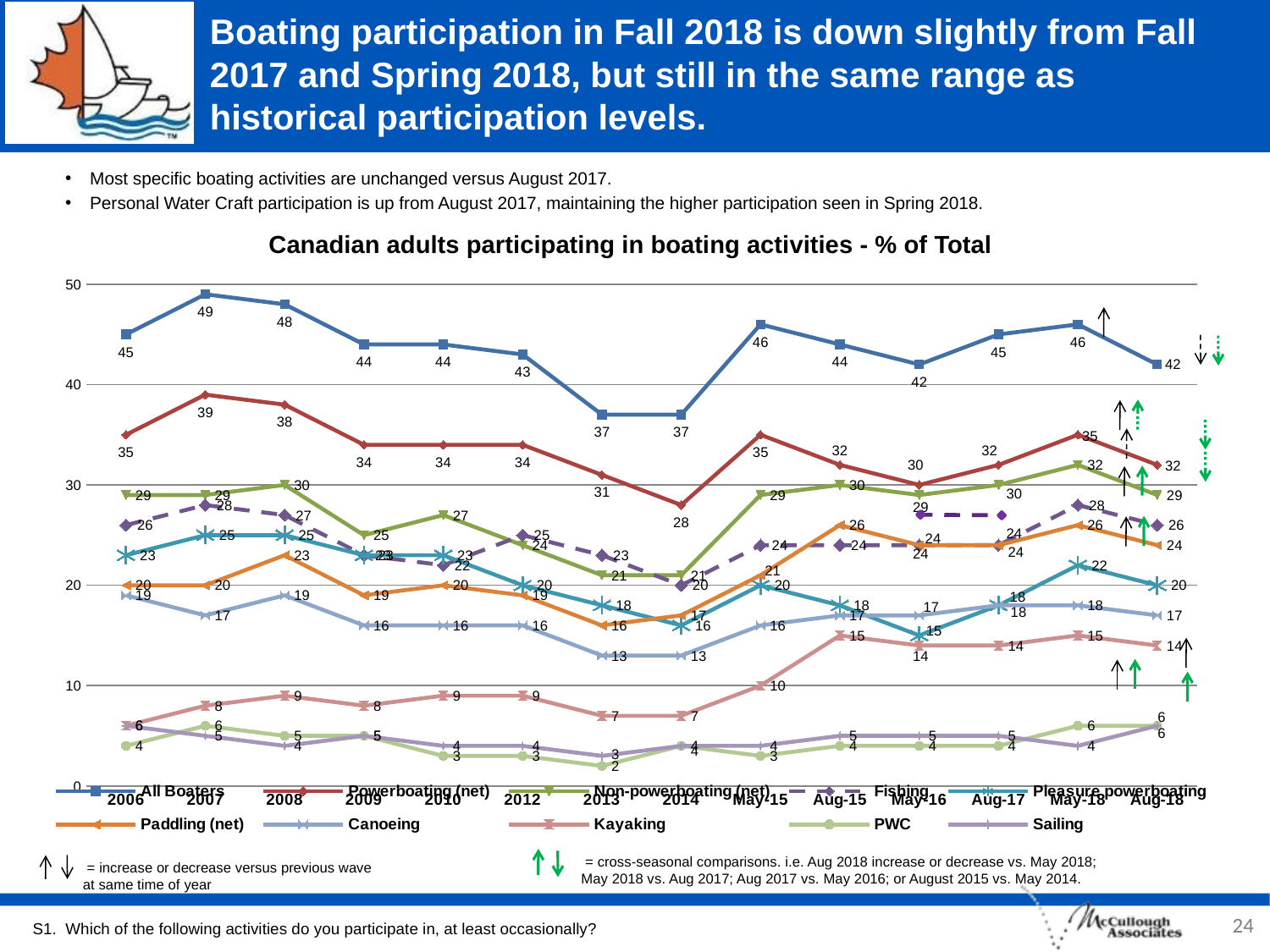
What kind of chart is shown on the slide? Line chart What is the difference between the All Boaters value in 2007 and in Aug-18? 7 How many series does the chart legend list? 10 Which is larger for All Boaters: the 2008 value or the 2009 value? 2008 What is the Powerboating (net) value for Aug-18? 32 How many time points are shown along the x axis of the chart? 14 What is the title of the chart? Canadian adults participating in boating activities - % of Total What is the All Boaters value for 2007? 49 Is the All Boaters value for 2013 greater or less than 40? less What is the Kayaking value for May-15? 10 In which year or wave is the Powerboating (net) value lowest? 2014 In which year or wave is the All Boaters value highest? 2007